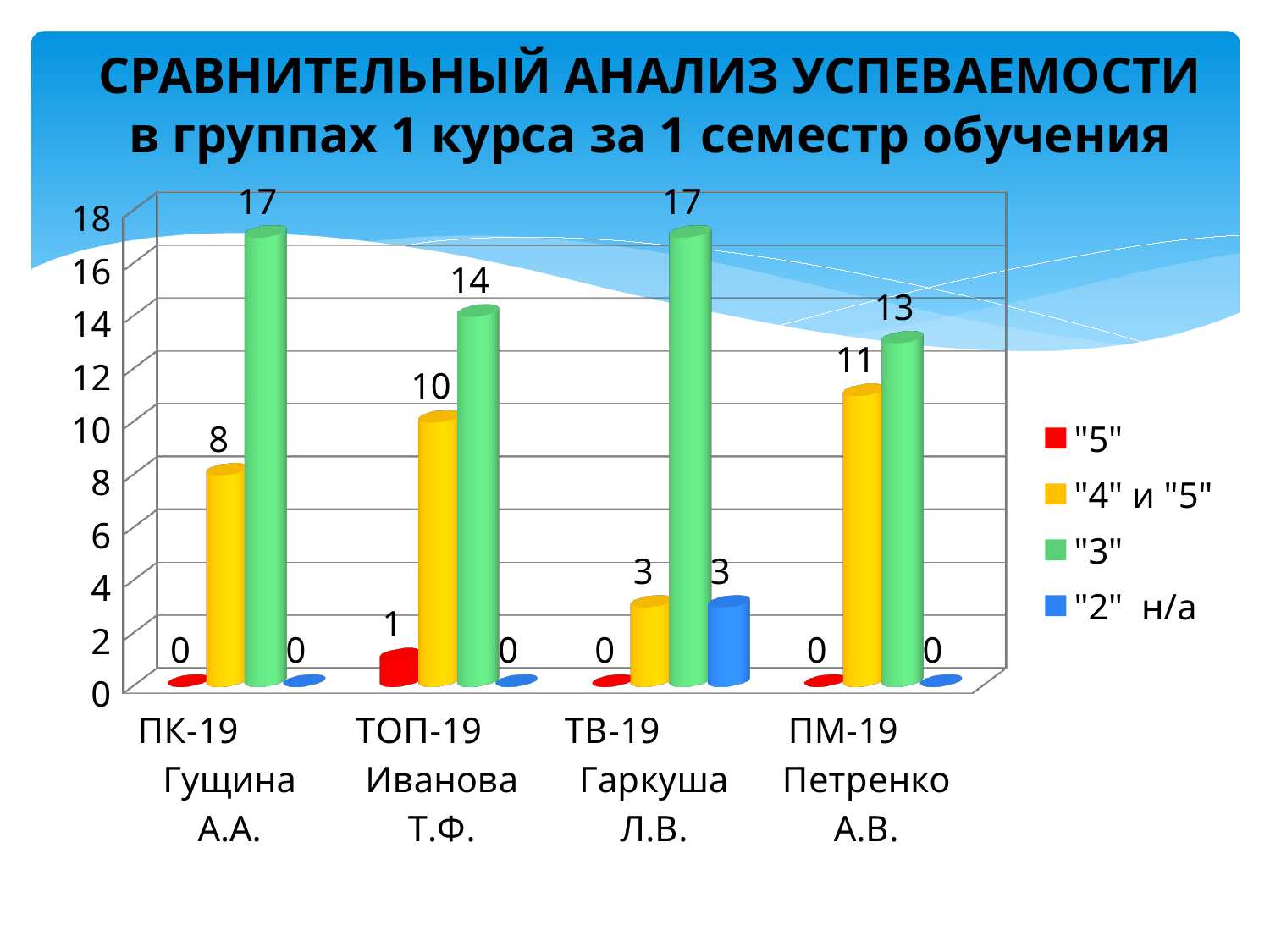
What is the difference between the "3" value and the "4" и "5" value for ПК-19 Гущина А.А.? 9 What colour represents the "3" series in the legend? Green Which is larger: the "4" и "5" value for ТОП-19 Иванова Т.Ф. or for ПМ-19 Петренко А.В.? ПМ-19 Петренко А.В. What is the value of the "2" н/а series for ТВ-19 Гаркуша Л.В.? 3 How many series does the legend list? 4 Which group has the lowest value in the "3" series? ПМ-19 Петренко А.В. What is the value of the "3" series for ТОП-19 Иванова Т.Ф.? 14 What kind of chart is shown on the slide? Bar chart How many groups are shown on the x axis? 4 What is the value of the "4" и "5" series for ПМ-19 Петренко А.В.? 11 Which group has the lowest value in the "4" и "5" series? ТВ-19 Гаркуша Л.В. What is the value of the "5" series for ТОП-19 Иванова Т.Ф.? 1